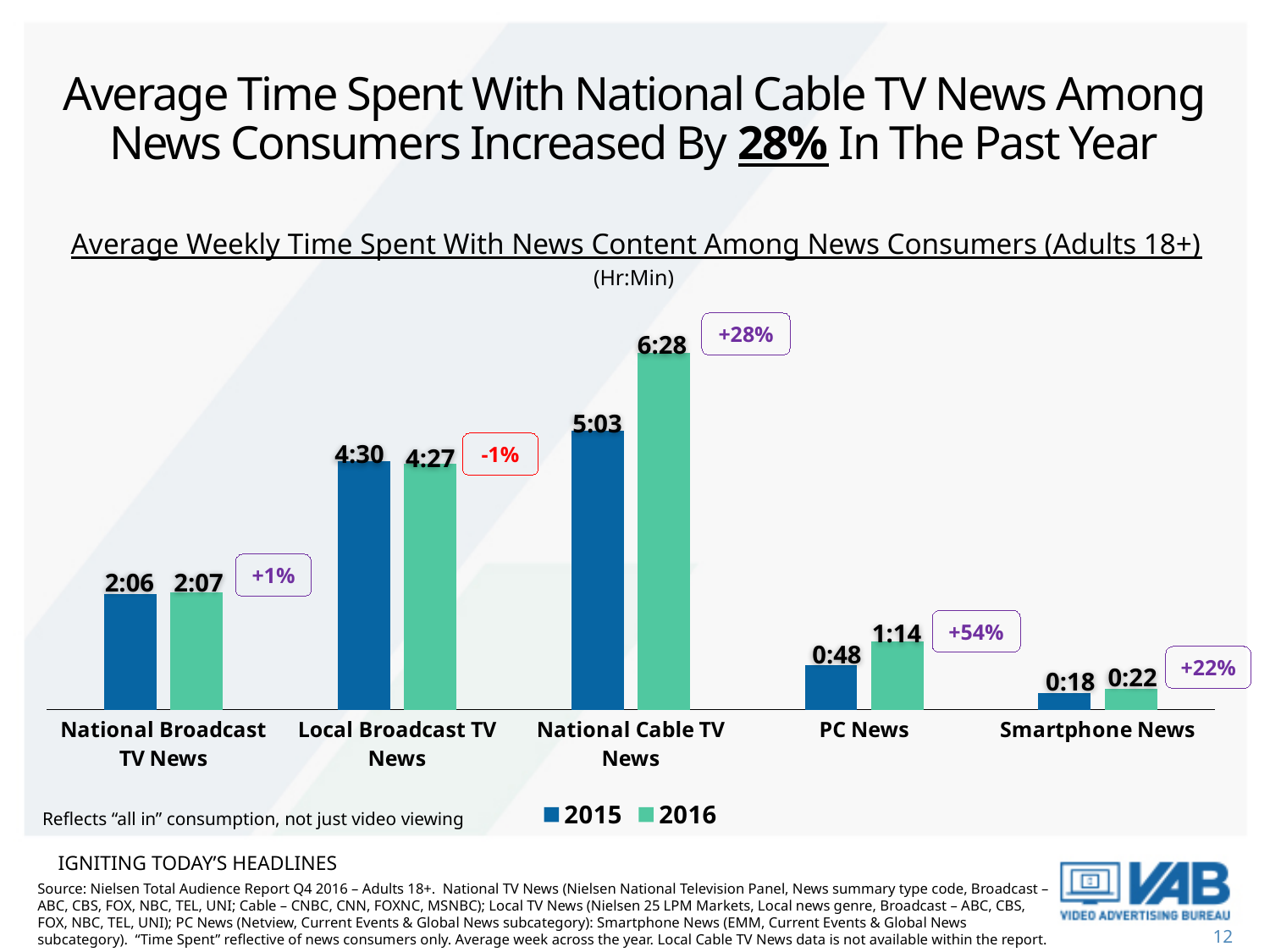
Which news category had the highest average weekly time spent in 2016? National Cable TV News What was the average weekly time spent with National Cable TV News in 2016? 6:28 How many series does the legend list? 2 What was the average weekly time spent with PC News in 2015? 0:48 What was the average weekly time spent with Smartphone News in 2016? 0:22 What percentage change is shown for PC News from 2015 to 2016? +54% Which news category had the lowest average weekly time spent in 2015? Smartphone News How many news categories are shown on the chart? 5 What kind of chart is shown on the slide? Bar chart Which was larger in 2016: time spent with National Broadcast TV News or PC News? National Broadcast TV News Which colour represents 2016 in the chart? Green What was the average weekly time spent with Local Broadcast TV News in 2015? 4:30